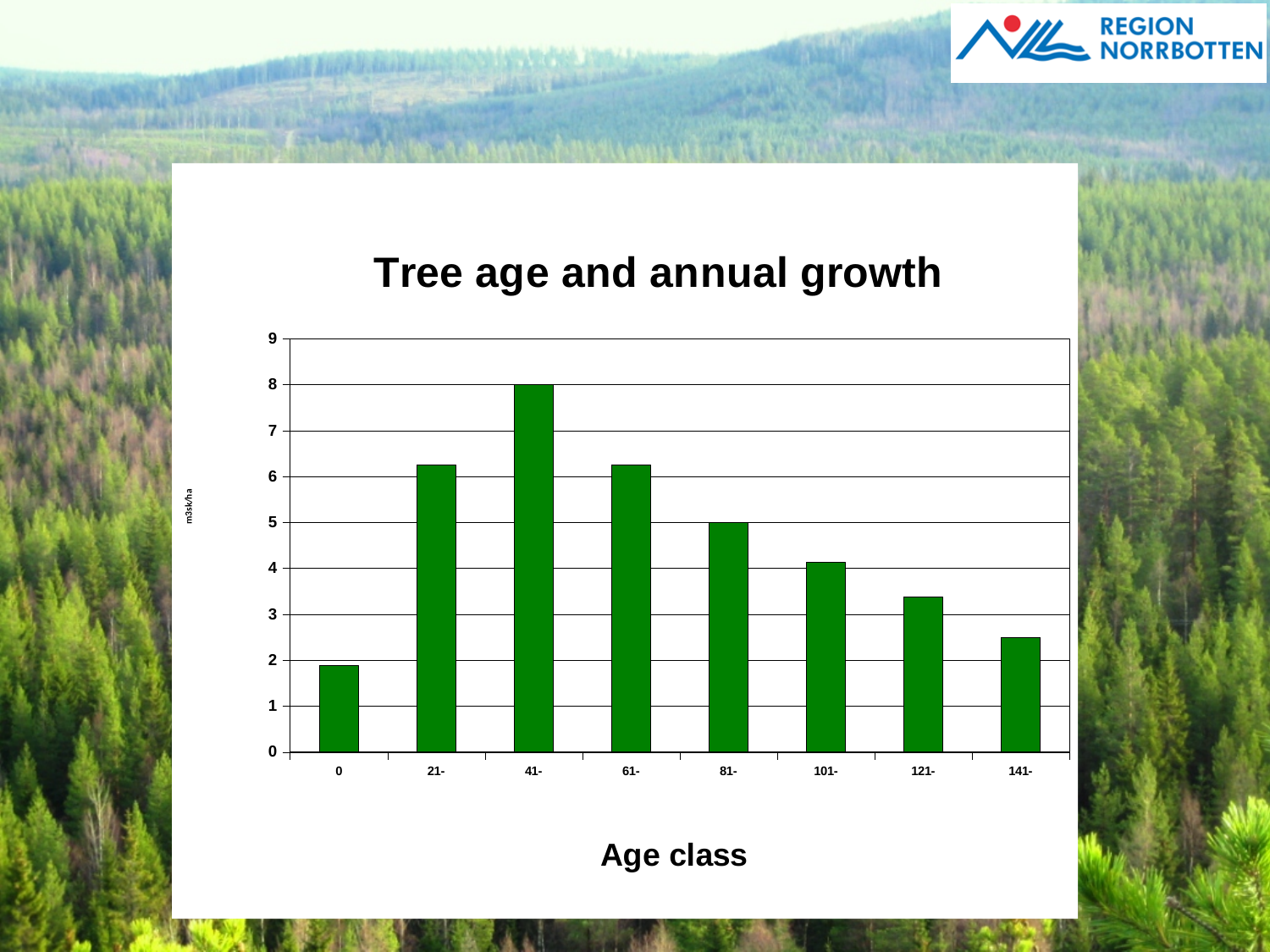
Is the value for the 21- age class greater or less than 6? greater Is the value for the 141- age class greater or less than 3? less What kind of chart is shown on the slide? bar chart From the 41- age class onward, do the values rise or fall along the x axis? fall How many age classes are plotted on the x axis? 8 Which age class has the highest annual growth? 41- Which age class has the lowest annual growth? 0 What is the value for the 81- age class? 5 What is the title of the chart? Tree age and annual growth What is the value for the 41- age class? 8 Is the value for the 0 age class greater or less than 2? less Which has the larger value, the 101- age class or the 121- age class? 101-